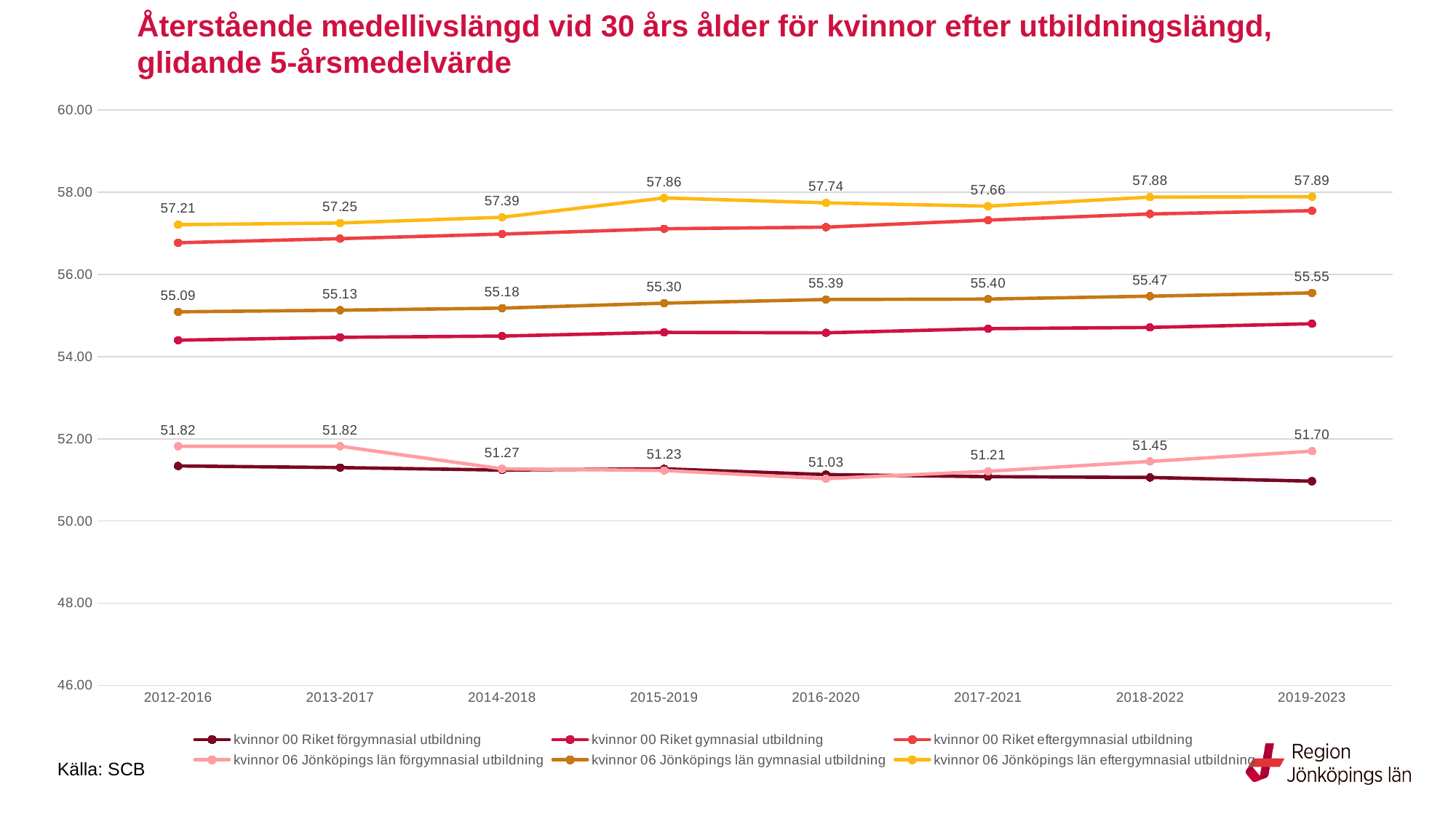
What is the value for kvinnor 06 Jönköpings län gymnasial utbildning in 2019-2023? 55.55 What is the value for kvinnor 06 Jönköpings län eftergymnasial utbildning in 2015-2019? 57.86 Which is larger for kvinnor 06 Jönköpings län förgymnasial utbildning: the value in 2012-2016 or in 2019-2023? 2012-2016 Does the value for kvinnor 06 Jönköpings län gymnasial utbildning rise or fall from 2012-2016 to 2019-2023? rise What kind of chart is shown on the slide? line chart In which period is the value for kvinnor 06 Jönköpings län förgymnasial utbildning lowest? 2016-2020 In which period is the value for kvinnor 06 Jönköpings län gymnasial utbildning highest? 2019-2023 What is the difference between the 2019-2023 and 2012-2016 values for kvinnor 06 Jönköpings län gymnasial utbildning? 0.46 How many periods are shown on the x axis? 8 How many series does the legend list? 6 What is the value for kvinnor 06 Jönköpings län förgymnasial utbildning in 2016-2020? 51.03 Is the value for kvinnor 00 Riket eftergymnasial utbildning in 2012-2016 greater or less than 56.00? greater